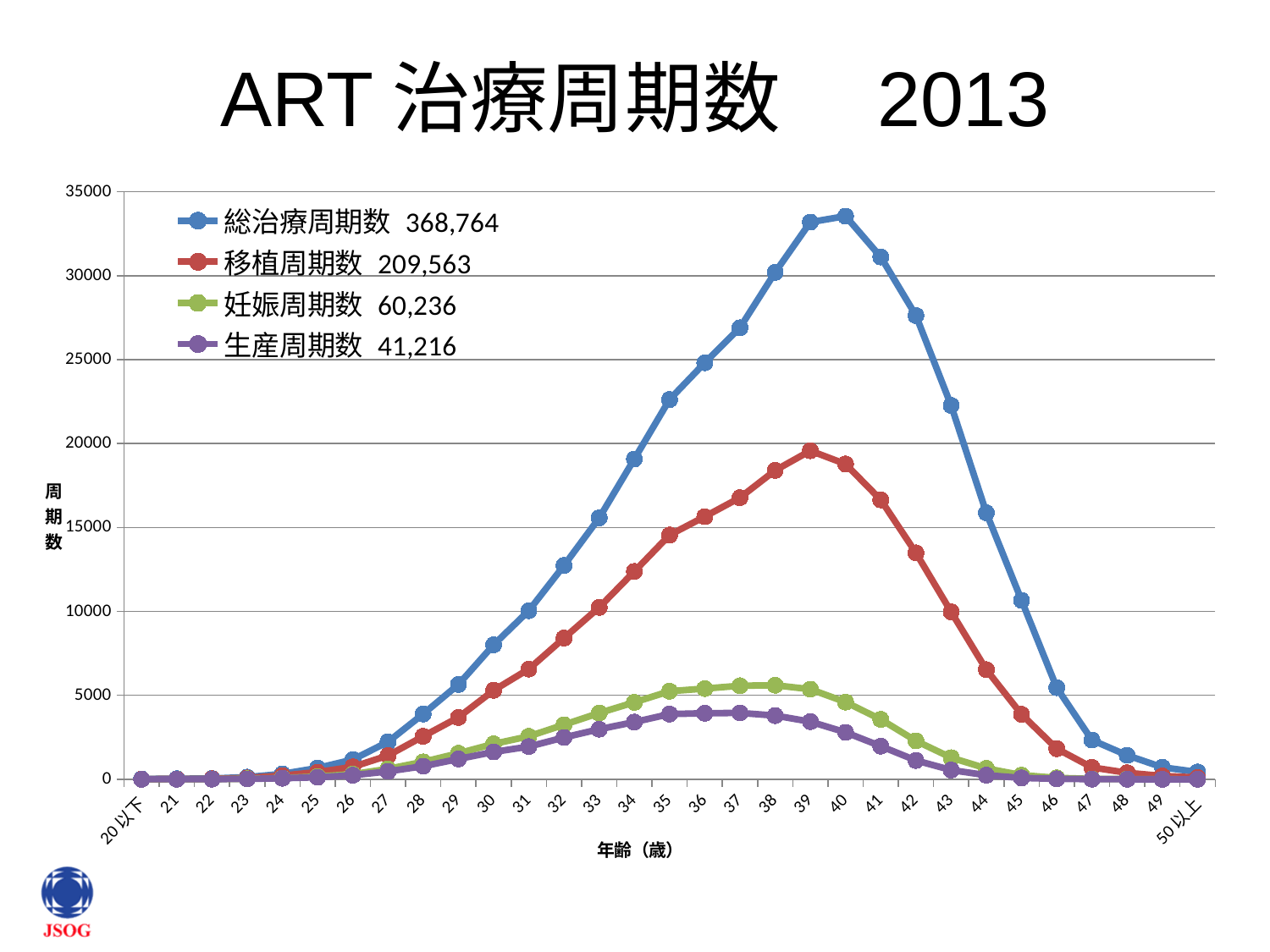
Is the value of 総治療周期数 at age 30 greater or less than 10000? less At age 35, which is larger: 総治療周期数 or 移植周期数? 総治療周期数 Does 総治療周期数 rise or fall from age 40 to 50以上? fall What kind of chart is shown on the slide? line chart How many series does the legend list? 4 What total is shown in the legend for 生産周期数? 41,216 Is the value of 総治療周期数 at age 40 greater or less than 30000? greater What total is shown in the legend for 移植周期数? 209,563 What total is shown in the legend for 妊娠周期数? 60,236 How many age categories are shown on the x axis? 31 What total is shown in the legend for 総治療周期数? 368,764 At which age does 移植周期数 reach its highest value? 39